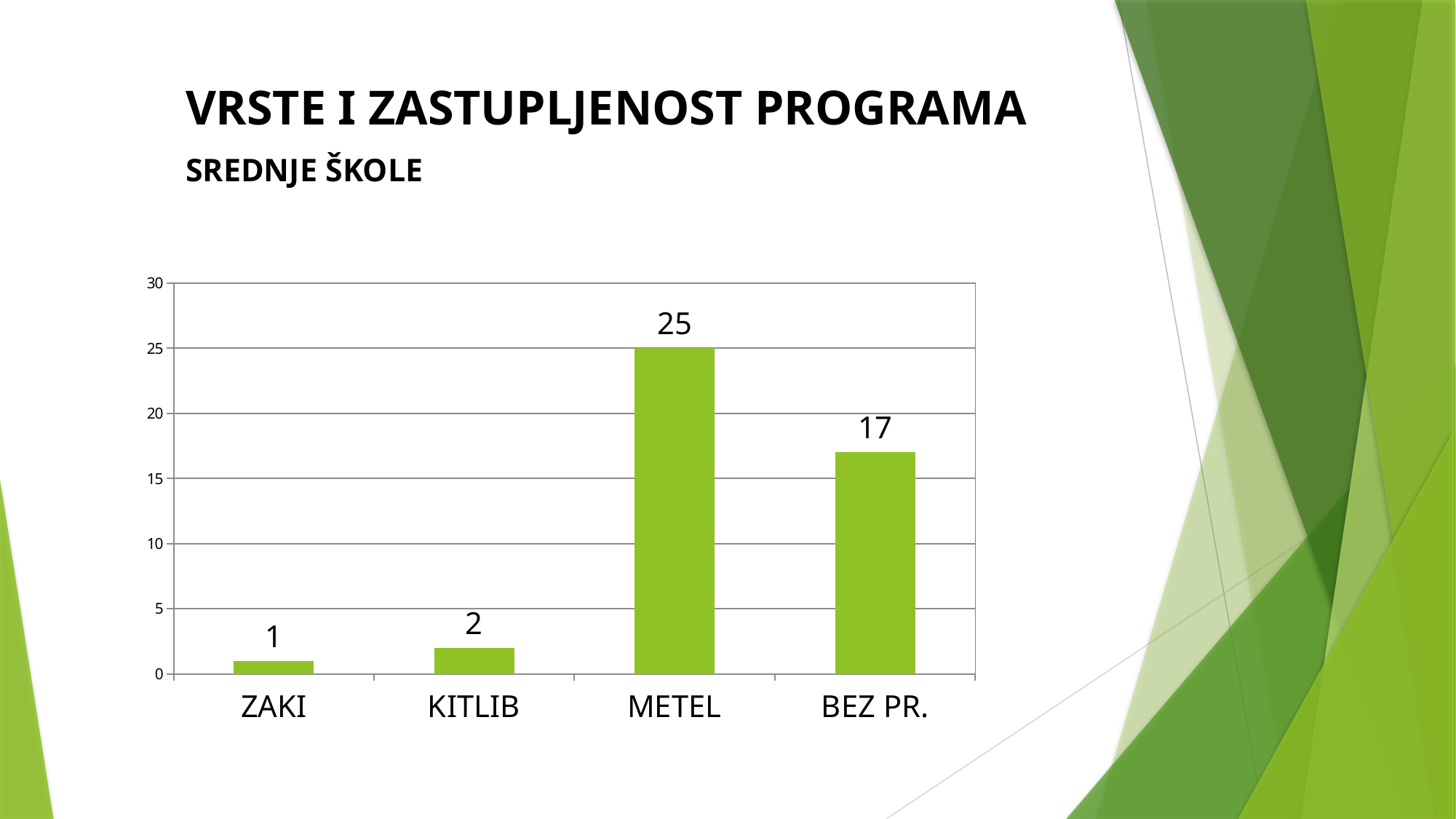
What is the value for ZAKI? 1 What is the difference between the values for METEL and BEZ PR.? 8 What is the value for BEZ PR.? 17 What is the title of the slide? VRSTE I ZASTUPLJENOST PROGRAMA What is the value for METEL? 25 What is the value for KITLIB? 2 How many categories are shown on the x axis? 4 Is the value for BEZ PR. greater or less than 20? less Which category has the lowest value? ZAKI What kind of chart is shown on the slide? bar chart Which category has the highest value? METEL Which is larger, the value for KITLIB or the value for ZAKI? KITLIB